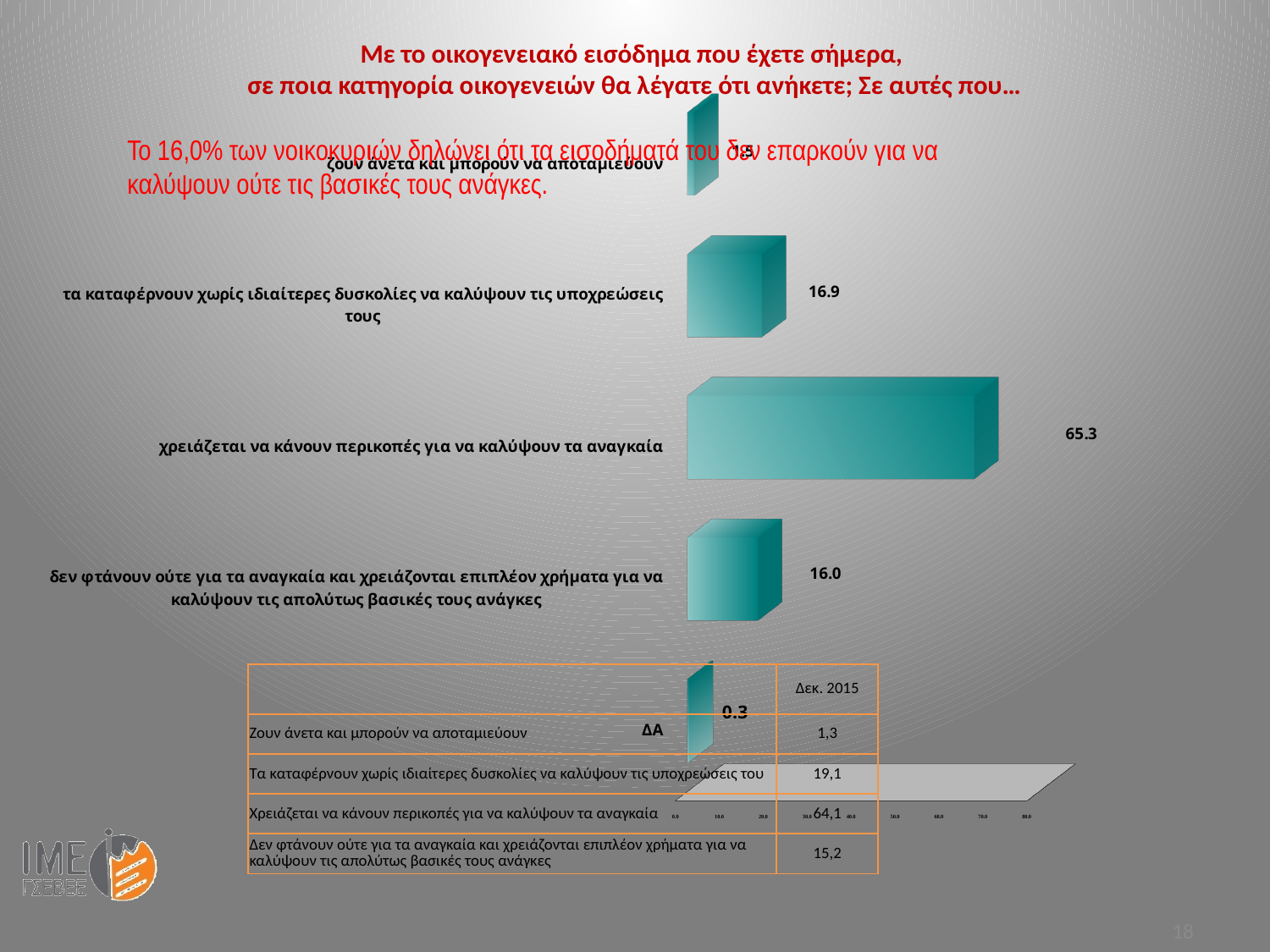
How many categories are plotted in the chart? 5 Which is larger: the value for 'τα καταφέρνουν χωρίς ιδιαίτερες δυσκολίες...' or the value for 'δεν φτάνουν ούτε για τα αναγκαία...'? τα καταφέρνουν χωρίς ιδιαίτερες δυσκολίες να καλύψουν τις υποχρεώσεις τους What is the difference between the values for 'χρειάζεται να κάνουν περικοπές για να καλύψουν τα αναγκαία' and 'δεν φτάνουν ούτε για τα αναγκαία...'? 49.3 What kind of chart is shown on the slide? Bar chart What value is shown for 'δεν φτάνουν ούτε για τα αναγκαία και χρειάζονται επιπλέον χρήματα για να καλύψουν τις απολύτως βασικές τους ανάγκες'? 16.0 What value is shown for the category 'χρειάζεται να κάνουν περικοπές για να καλύψουν τα αναγκαία'? 65.3 Which category has the lowest value in the chart? ΔΑ What colour are the bars in the chart? Teal What value is shown for the 'ΔΑ' category? 0.3 Which category has the highest value in the chart? χρειάζεται να κάνουν περικοπές για να καλύψουν τα αναγκαία What value is shown for 'τα καταφέρνουν χωρίς ιδιαίτερες δυσκολίες να καλύψουν τις υποχρεώσεις τους'? 16.9 What is the difference between the values for 'τα καταφέρνουν χωρίς ιδιαίτερες δυσκολίες...' and 'δεν φτάνουν ούτε για τα αναγκαία...'? 0.9